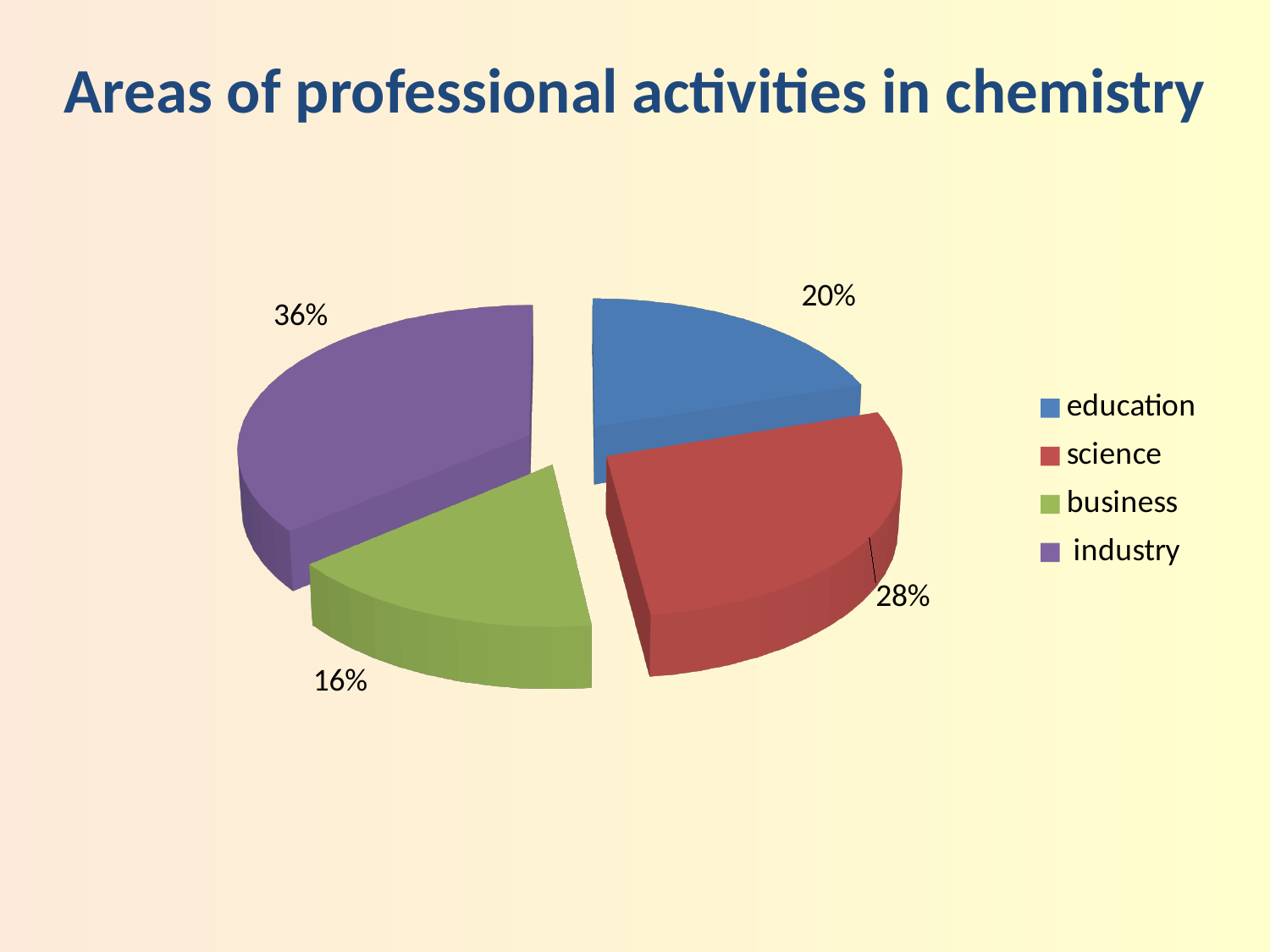
What share of the pie does science have? 28% What share of the pie does education have? 20% What is the difference between the shares for science and education? 8% What share of the pie does industry have? 36% What is the difference between the shares for industry and business? 20% How many slices does the pie chart have? 4 Which area has the smallest share of the pie? business Which has a larger share, science or education? science What kind of chart is shown on the slide? pie chart What is the title of the slide? Areas of professional activities in chemistry Which area has the largest share of the pie? industry